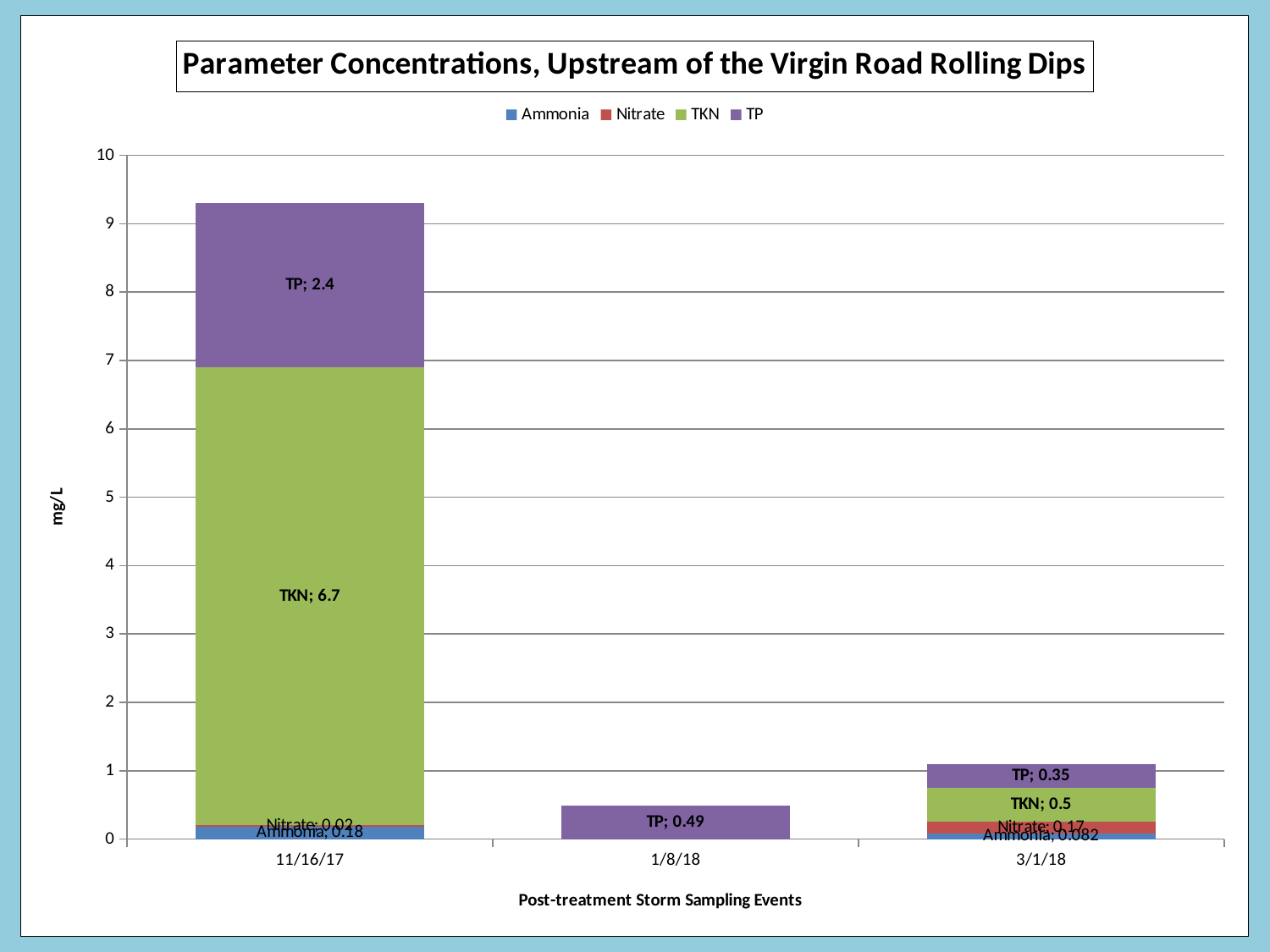
What is the label on the y axis? mg/L Which sampling event has the larger TP concentration, 1/8/18 or 3/1/18? 1/8/18 What kind of chart is shown on the slide? Stacked bar chart What is the TP concentration for the 1/8/18 sampling event? 0.49 What is the TP concentration for the 3/1/18 sampling event? 0.35 What is the TKN concentration for the 11/16/17 sampling event? 6.7 How many post-treatment storm sampling events are shown on the x axis? 3 What is the difference between the TP concentration on 11/16/17 and on 3/1/18? 2.05 How many series does the legend list? 4 What is the TP concentration for the 11/16/17 sampling event? 2.4 Which sampling event has the highest total stacked bar? 11/16/17 What is the TKN concentration for the 3/1/18 sampling event? 0.5